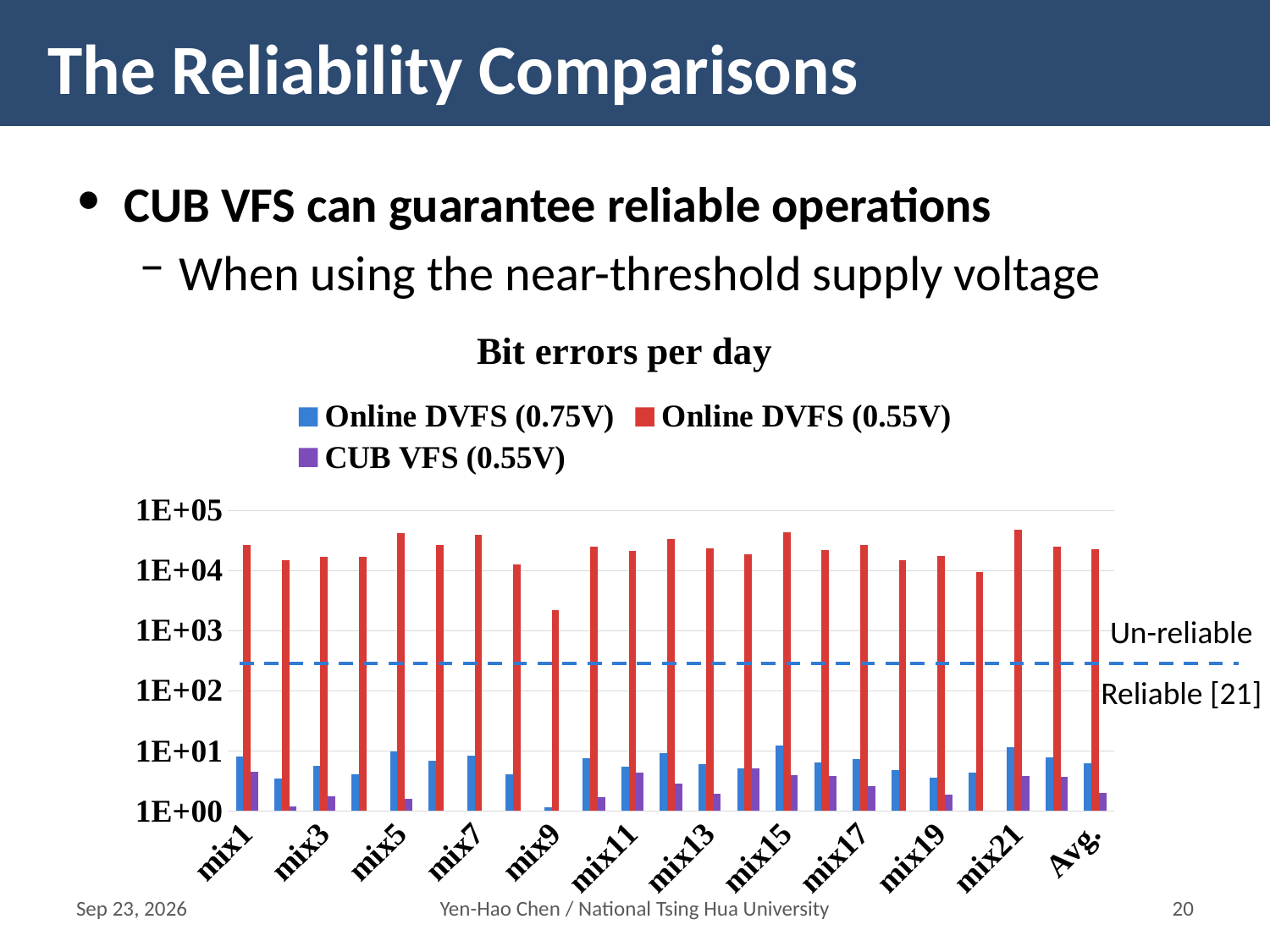
Is the value for Online DVFS (0.55V) at mix9 greater or less than 1E+04? less Is the value for CUB VFS (0.55V) at mix1 greater or less than 1E+01? less Is the value for Online DVFS (0.55V) at Avg. greater or less than 1E+03? greater Which series is drawn in red in the chart? Online DVFS (0.55V) How many series does the legend of the 'Bit errors per day' chart list? 3 For mix1, which is larger: Online DVFS (0.55V) or CUB VFS (0.55V)? Online DVFS (0.55V) What kind of chart is shown on the slide? bar chart What is the title of the chart? Bit errors per day Among the labeled categories, which has the lowest value for Online DVFS (0.55V)? mix9 Which series has the highest bit errors per day across the categories? Online DVFS (0.55V)